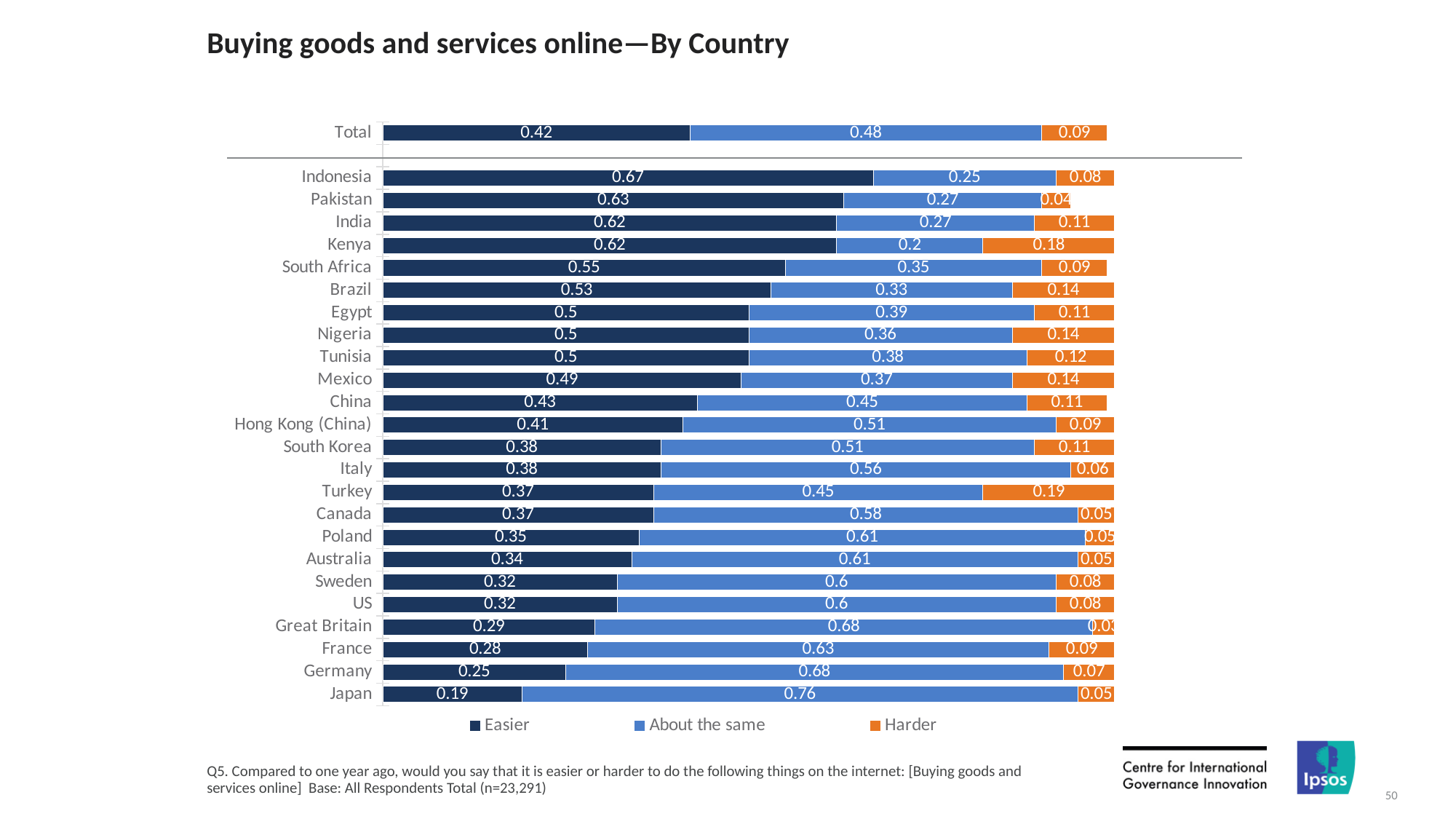
How many countries are listed below the Total row? 24 What is the 'Easier' value for the Total row? 0.42 What is the 'Harder' value for Kenya? 0.18 Which country has the highest 'Harder' value? Turkey What is the difference between the 'Easier' values for Indonesia and Japan? 0.48 What kind of chart is shown on the slide? Stacked bar chart What is the 'Easier' value for Indonesia? 0.67 Which country has the highest 'Easier' value? Indonesia Which is larger, the 'About the same' value for Germany or for France? Germany How many series does the legend list? 3 Which country has the lowest 'Easier' value? Japan What is the 'About the same' value for Japan? 0.76